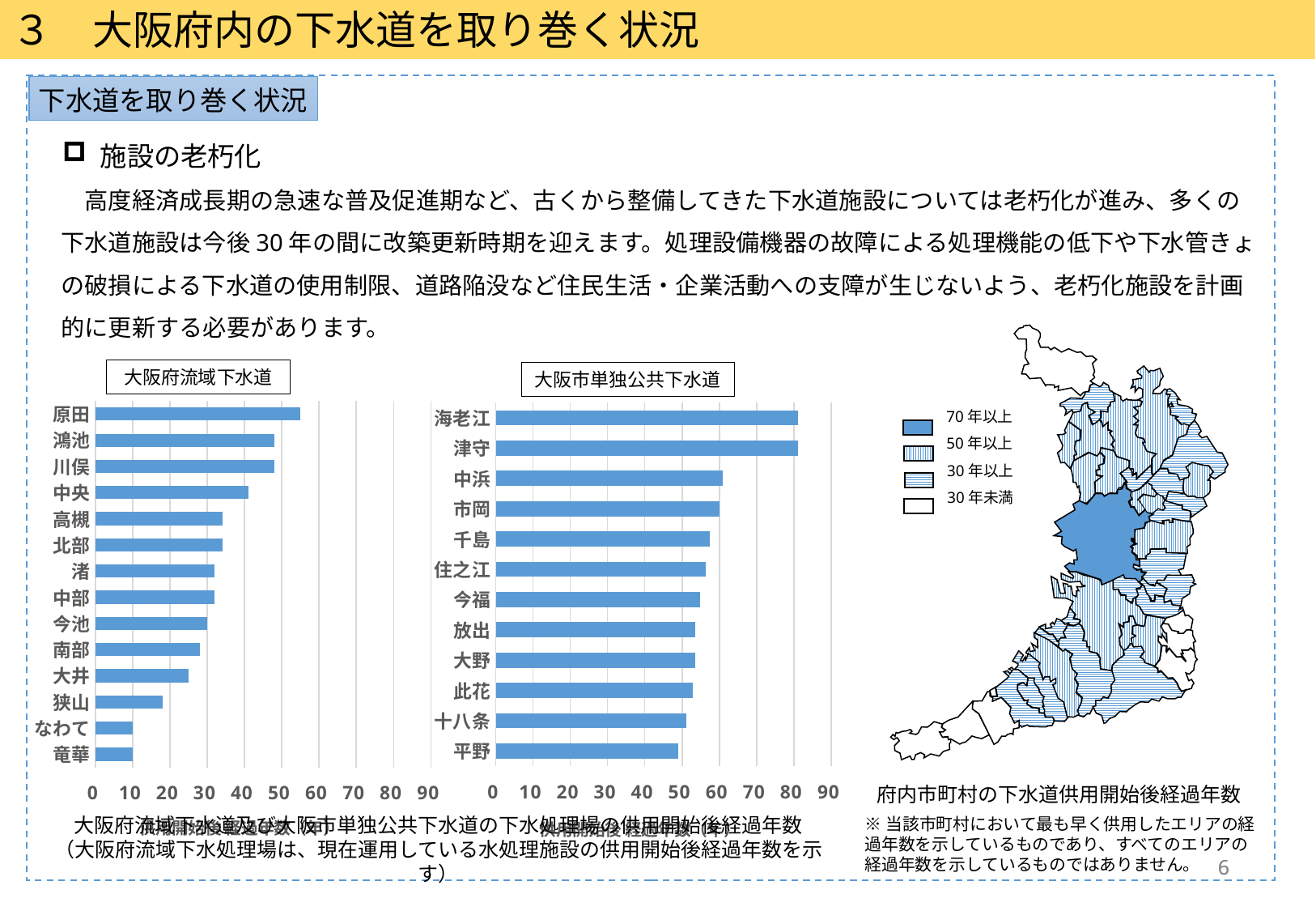
In the 大阪市単独公共下水道 chart, which is larger, the value for 海老江 or the value for 中浜? 海老江 In the 大阪府流域下水道 chart, is the value for 狭山 greater or less than 20? less In the 大阪府流域下水道 chart, is the value for 原田 greater or less than 50? greater How many treatment plants (categories) are shown in the 大阪府流域下水道 chart? 14 What kind of chart is the 大阪府流域下水道 chart? bar chart In the 大阪府流域下水道 chart, is the value for 大井 greater or less than 30? less In the 大阪府流域下水道 chart, which is larger, the value for 原田 or the value for 中央? 原田 In the 大阪府流域下水道 chart, which plant has the highest value? 原田 How many treatment plants (categories) are shown in the 大阪市単独公共下水道 chart? 12 What is the title shown above the middle bar chart? 大阪市単独公共下水道